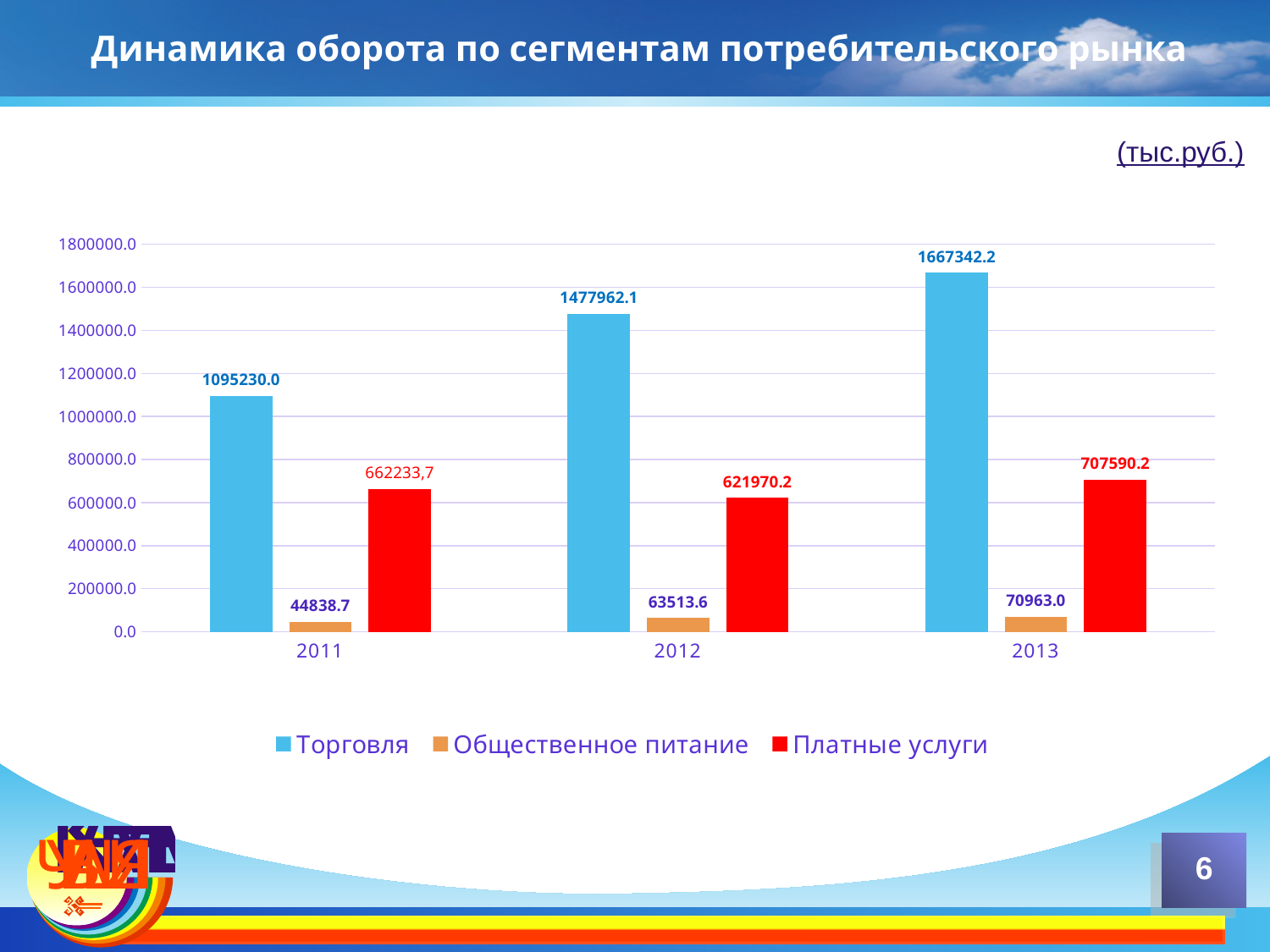
In which year is the value for Торговля the highest? 2013 How many years are shown on the x axis? 3 What is the value for Торговля in 2013? 1667342.2 What is the value for Общественное питание in 2011? 44838.7 What kind of chart is shown on the slide? bar chart What is the value for Торговля in 2011? 1095230.0 What is the value for Платные услуги in 2012? 621970.2 How many series does the legend list? 3 Do the values for Торговля rise or fall from 2011 to 2013? rise What is the difference between the Торговля values for 2013 and 2012? 189380.1 Which is larger: the value for Платные услуги in 2011 or in 2012? 2011 In which year is the value for Общественное питание the lowest? 2011